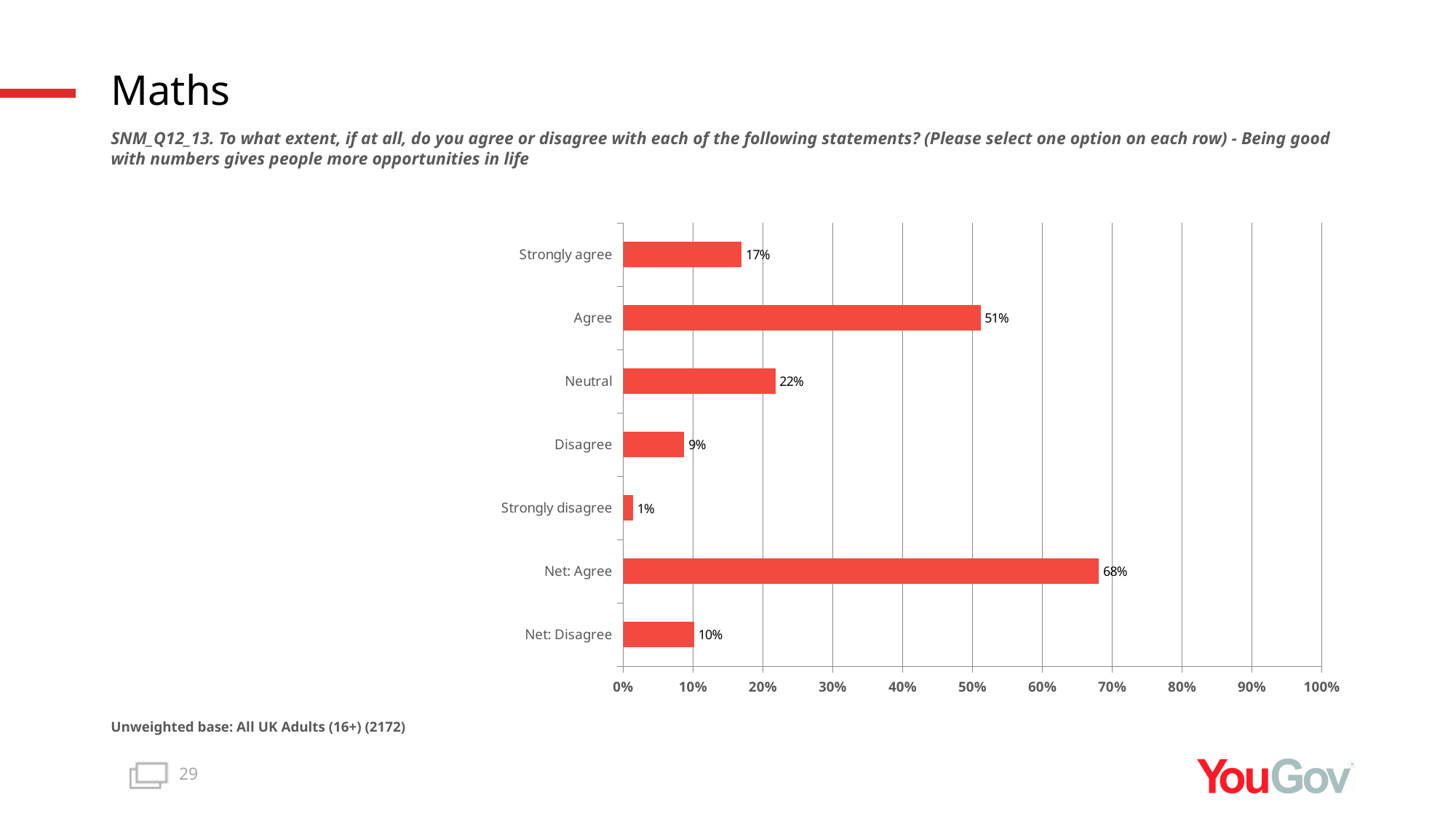
What kind of chart is shown on the slide? Bar chart What is the value shown for 'Net: Agree'? 68% Which category has the highest value? Net: Agree What is the difference between 'Agree' and 'Strongly agree'? 34% Is the value for 'Agree' greater or less than 50%? greater Which category has the lowest value? Strongly disagree What is the difference between 'Net: Agree' and 'Net: Disagree'? 58% How many categories are shown on the chart? 7 Which is larger, 'Neutral' or 'Disagree'? Neutral What is the unweighted base stated below the chart? All UK Adults (16+) (2172) What percentage of respondents selected 'Neutral'? 22% What percentage of respondents selected 'Agree'? 51%